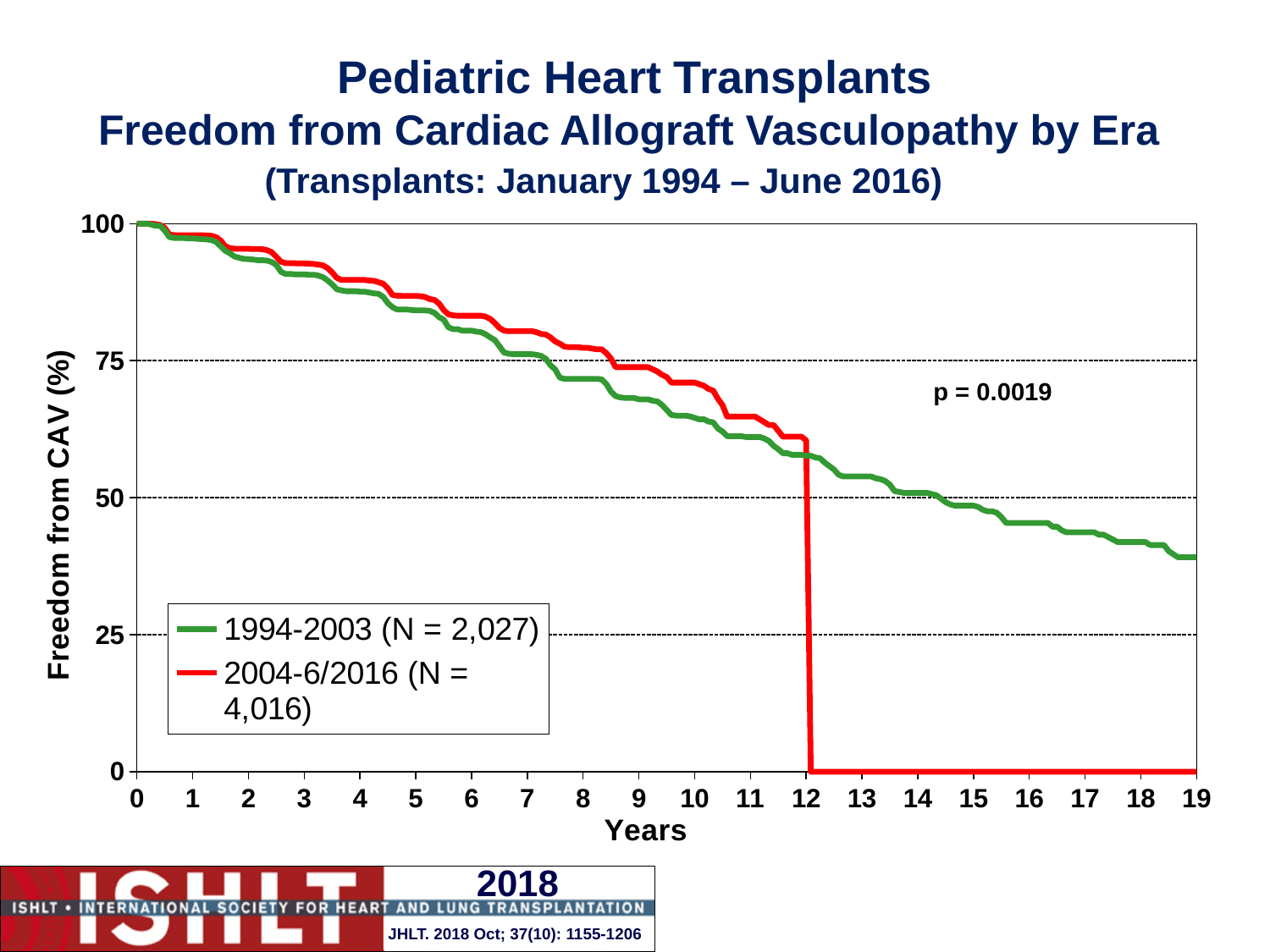
What is the value of both series at 0 years? 100 What kind of chart is shown on the slide? line chart Is the value for the 2004-6/2016 series at 11 years greater or less than 50? greater How many series does the legend list? 2 Is the value for the 1994-2003 series at 10 years greater or less than 75? less Does the 1994-2003 series rise or fall as years increase? fall Is the value for the 1994-2003 series at 18 years greater or less than 50? less What is the label of the y axis? Freedom from CAV (%) Which series has the higher value at 9 years, 1994-2003 or 2004-6/2016? 2004-6/2016 What is the p-value printed on the chart? p = 0.0019